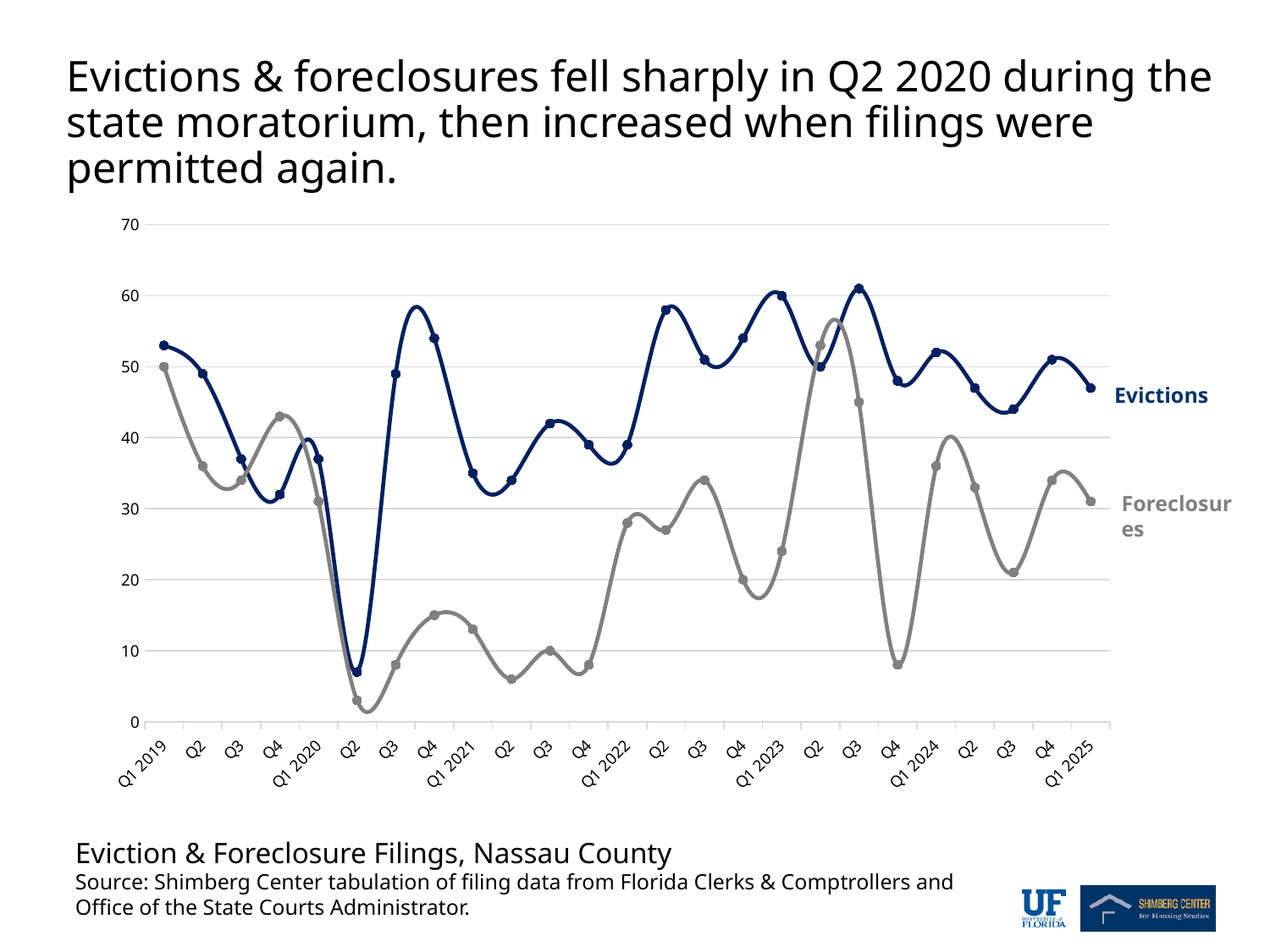
In Q4 2019, which series has the higher value, Evictions or Foreclosures? Foreclosures Which series is drawn in gray? Foreclosures Is the value for Foreclosures in Q4 2023 greater or less than 10? less In which quarter do Evictions reach their lowest value? Q2 2020 How many quarterly data points are plotted for each series? 25 In which quarter do Foreclosures reach their lowest value? Q2 2020 How many series does the chart show? 2 Is the value for Evictions in Q1 2021 greater or less than 40? less Is the value for Evictions in Q2 2020 greater or less than 10? less In Q4 2023, which series has the higher value, Evictions or Foreclosures? Evictions What kind of chart is shown on the slide? line chart